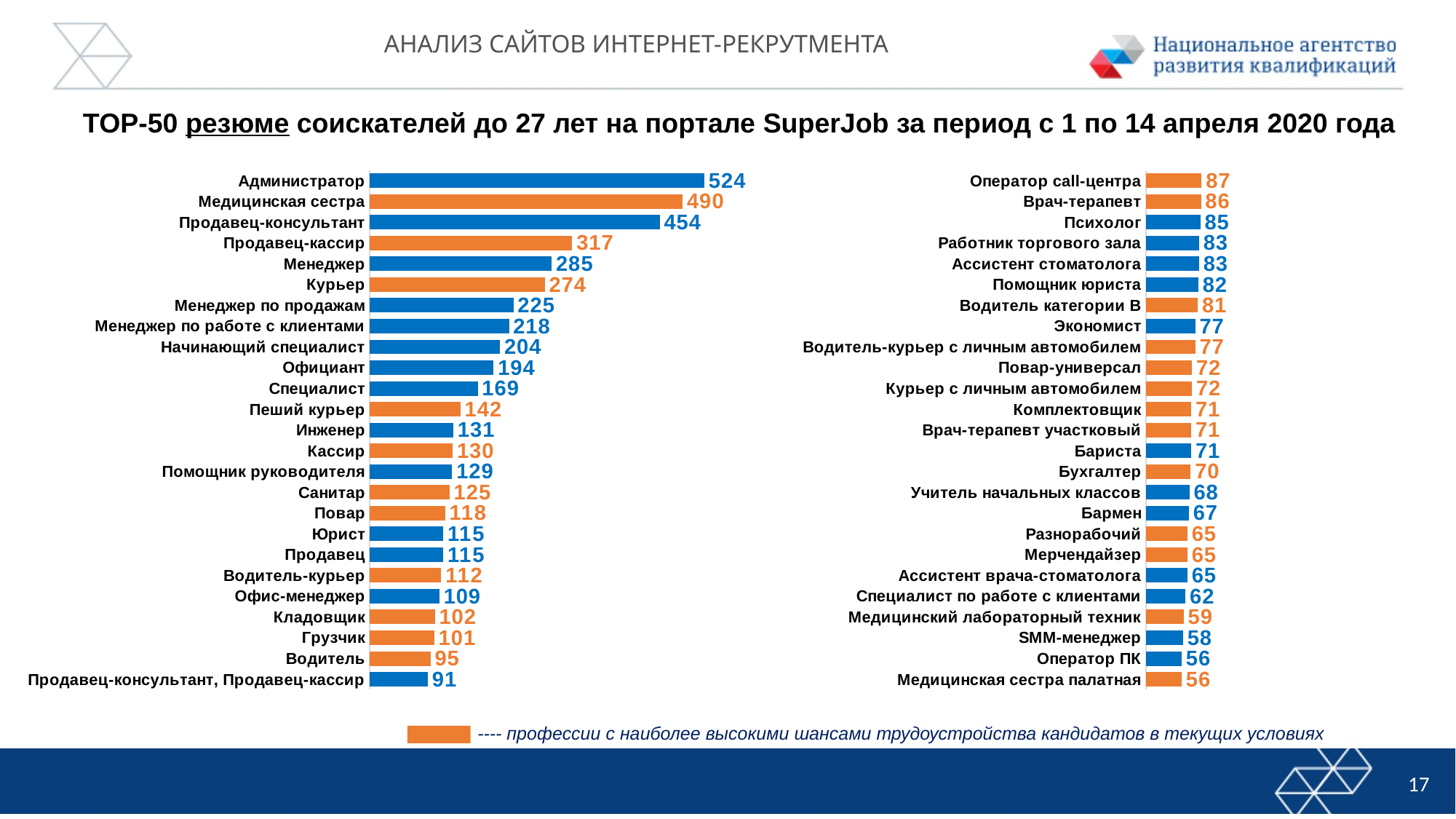
In the left chart, what is the value for Курьер? 274 In the right chart, which category has the highest value? Оператор call-центра In the left chart, what is the difference between the values for Администратор and Медицинская сестра? 34 In the left chart, what is the value for Администратор? 524 In the left chart, which category has the lowest value? Продавец-консультант, Продавец-кассир How many categories are shown in the left chart? 25 In the right chart, what is the difference between the values for Оператор call-центра and Медицинская сестра палатная? 31 What type of chart is used on this slide? Bar chart In the right chart, what is the value for Бухгалтер? 70 In the right chart, what is the value for Психолог? 85 In the left chart, which category has the highest value? Администратор In the left chart, which is larger, the value for Менеджер or the value for Продавец-кассир? Продавец-кассир